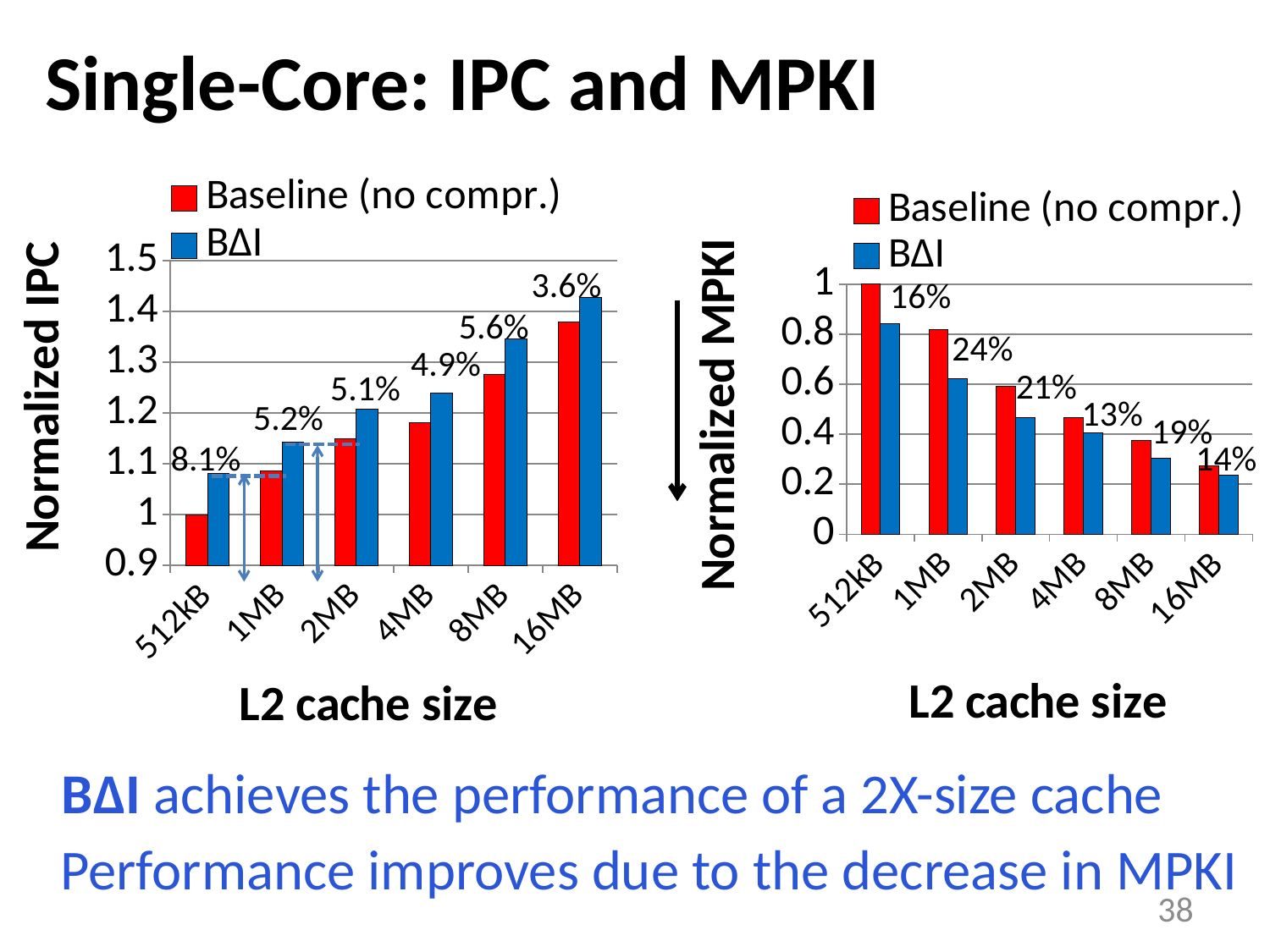
In the Normalized IPC chart, what percentage label is shown above the 512kB bars? 8.1% In the Normalized MPKI chart, what percentage label is shown for 1MB? 24% In the Normalized IPC chart, do the values rise or fall as L2 cache size increases along the x axis? rise What kind of chart is the Normalized IPC chart on the left? bar chart In the Normalized MPKI chart, do the values rise or fall as L2 cache size increases along the x axis? fall In the Normalized IPC chart, is the Baseline (no compr.) value for 4MB greater or less than 1.2? less In the Normalized MPKI chart, is the BΔI value for 512kB greater or less than 0.8? greater In the Normalized MPKI chart, which L2 cache size has the largest percentage label? 1MB How many L2 cache sizes are shown on the x axis of the Normalized IPC chart? 6 In the Normalized MPKI chart, which is larger at 512kB, Baseline (no compr.) or BΔI? Baseline (no compr.) How many series does the legend of the Normalized MPKI chart list? 2 In the Normalized IPC chart, which L2 cache size has the smallest percentage label? 16MB